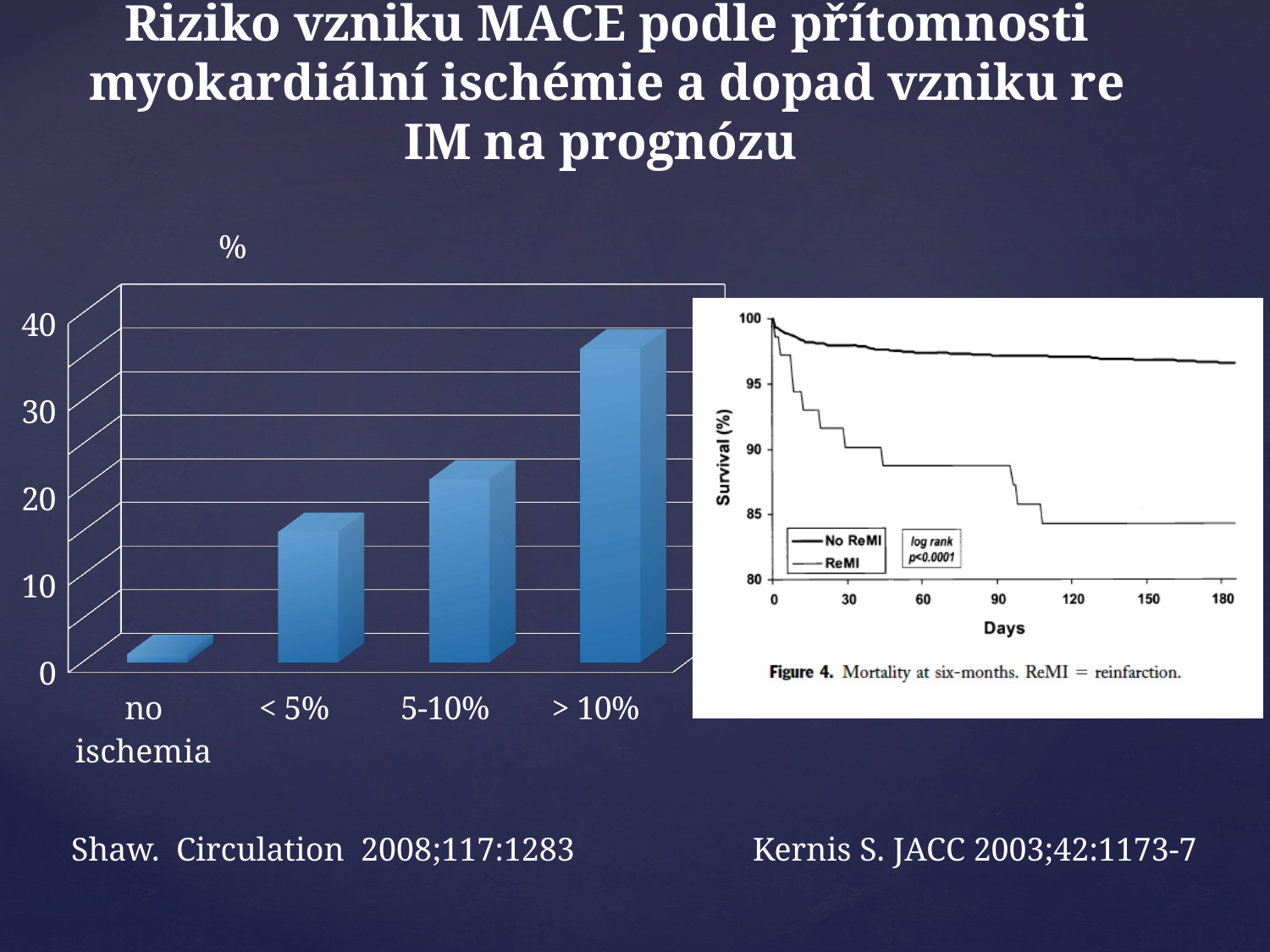
In the left bar chart, is the value for "no ischemia" greater or less than 10? less In the left bar chart, is the value for "5-10%" greater or less than 30? less In the left bar chart, is the value for "> 10%" greater or less than 30? greater In the left bar chart, which is larger, the value for "< 5%" or the value for "5-10%"? 5-10% In the left bar chart, which category has the lowest value? no ischemia How many categories does the left bar chart show? 4 In the left bar chart, which category has the highest value? > 10% What kind of chart is the left chart on the slide? bar chart In the right survival chart, which series has the higher survival at 180 days? No ReMI In the left bar chart, do the values rise or fall from "no ischemia" to "> 10%"? rise How many series does the legend of the right survival chart list? 2